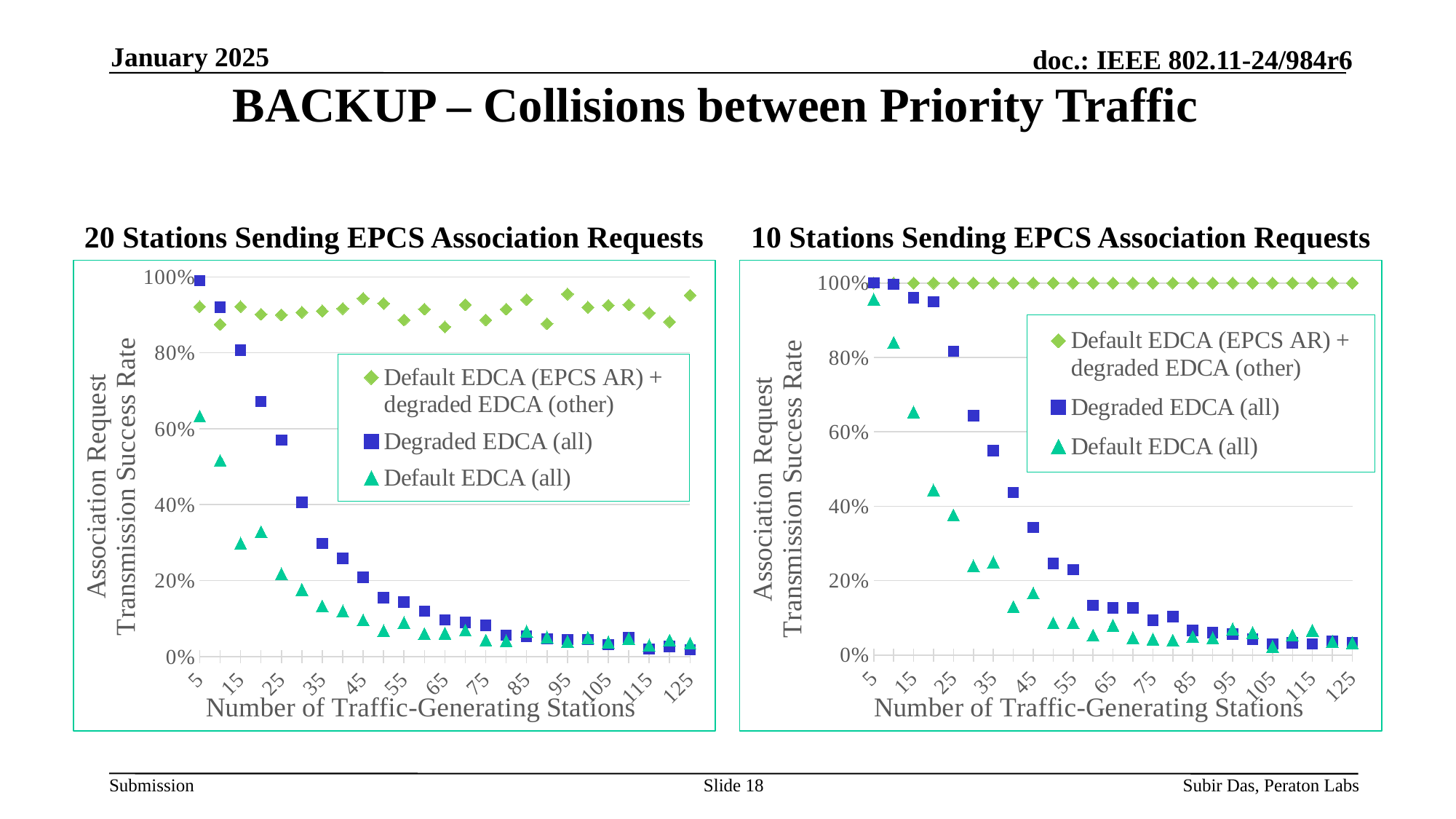
In the left chart ('20 Stations Sending EPCS Association Requests'), is the value for Default EDCA (all) at 5 stations greater or less than 40%? greater In the left chart ('20 Stations Sending EPCS Association Requests'), at 25 stations, which is larger: Degraded EDCA (all) or Default EDCA (all)? Degraded EDCA (all) In the left chart ('20 Stations Sending EPCS Association Requests'), is the value for Degraded EDCA (all) at 5 stations greater or less than 80%? greater What is the y-axis label of the right chart ('10 Stations Sending EPCS Association Requests')? Association Request Transmission Success Rate What is the x-axis label of the left chart ('20 Stations Sending EPCS Association Requests')? Number of Traffic-Generating Stations In the right chart ('10 Stations Sending EPCS Association Requests'), is the value for Default EDCA (EPCS AR) + degraded EDCA (other) at 65 stations greater or less than 80%? greater In the left chart ('20 Stations Sending EPCS Association Requests'), does the Degraded EDCA (all) series rise or fall as the number of traffic-generating stations increases? fall What kind of chart is the left chart titled '20 Stations Sending EPCS Association Requests'? scatter chart How many series does the legend of the right chart ('10 Stations Sending EPCS Association Requests') list? 3